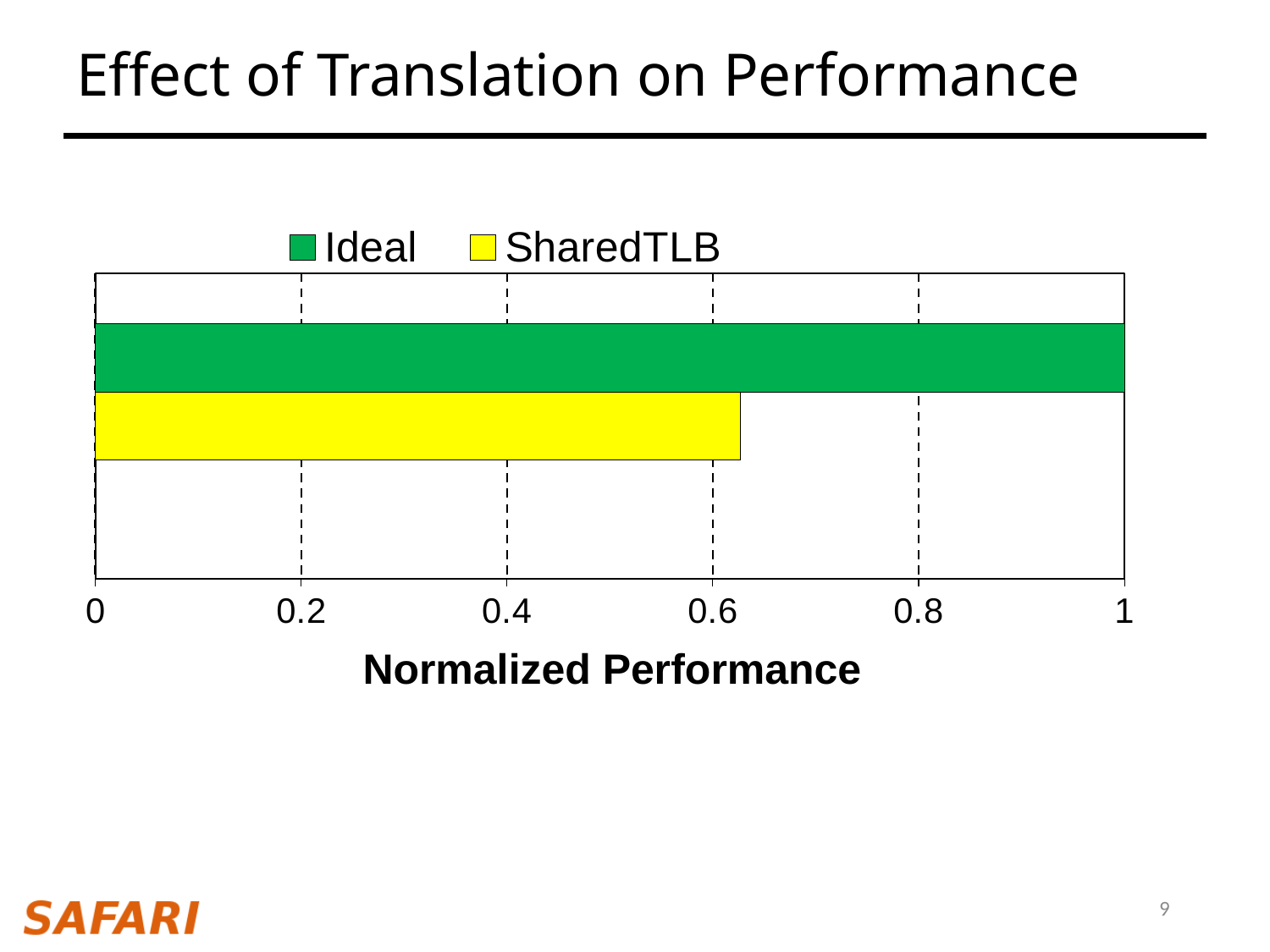
Is the value for SharedTLB greater or less than 0.6? greater How many bars are plotted in the chart? 2 What are the two series named in the legend? Ideal and SharedTLB Is the value for Ideal greater or less than 0.8? greater What is the normalized performance value for Ideal? 1 Which series has the lowest normalized performance? SharedTLB Which series has the highest normalized performance? Ideal How many series does the legend list? 2 Which series has the higher normalized performance, Ideal or SharedTLB? Ideal Is the value for SharedTLB greater or less than 0.8? less What is the label of the horizontal axis? Normalized Performance What kind of chart is shown on the slide? bar chart